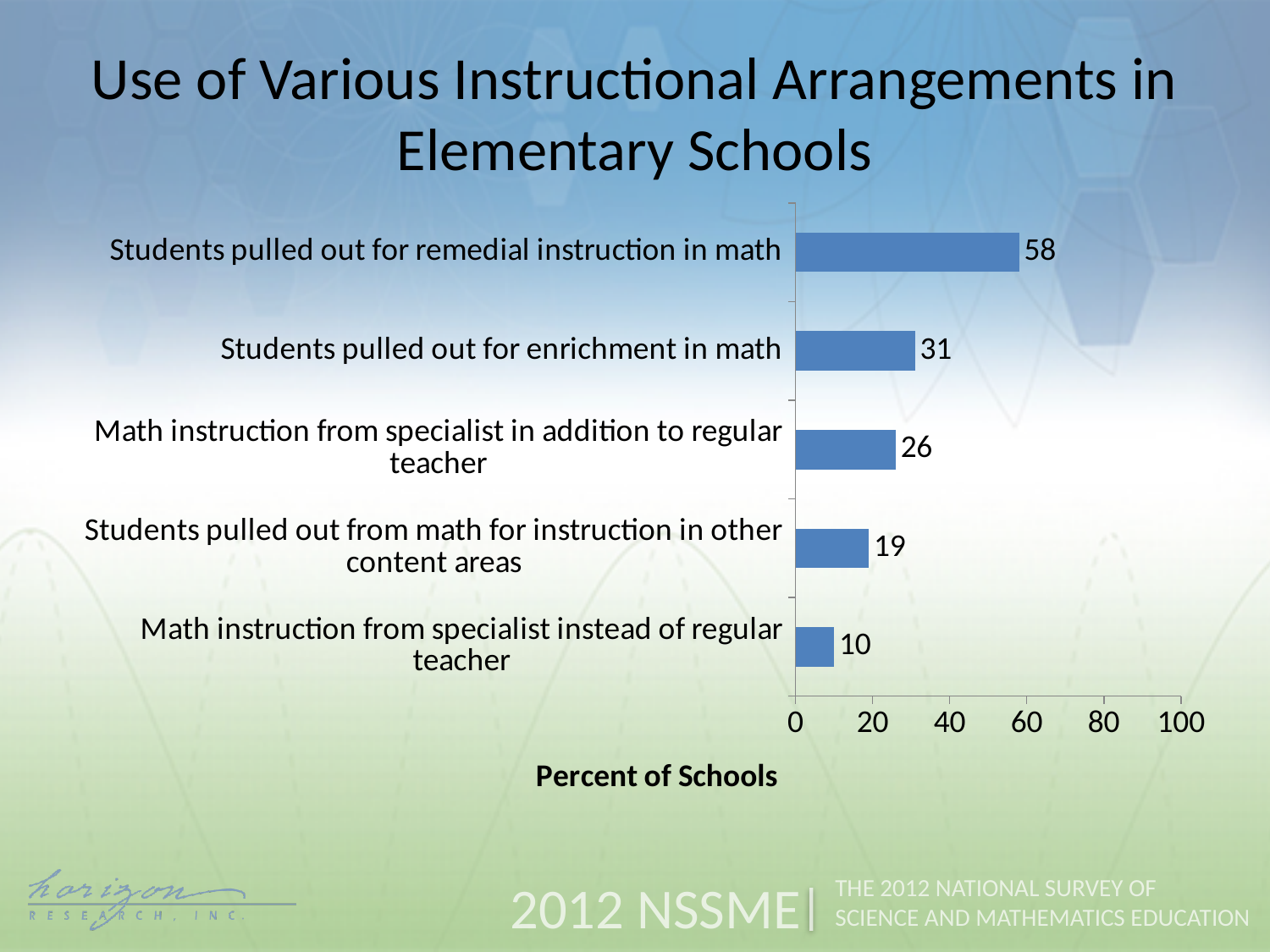
What is the difference between the values for students pulled out for remedial instruction in math and students pulled out for enrichment in math? 27 How many instructional arrangements are shown in the chart? 5 Which is larger: the value for students pulled out from math for instruction in other content areas or the value for math instruction from specialist in addition to regular teacher? Math instruction from specialist in addition to regular teacher Is the value for students pulled out for remedial instruction in math greater or less than 40? greater What is the value for students pulled out for enrichment in math? 31 What is the value for math instruction from specialist instead of regular teacher? 10 Which instructional arrangement has the lowest percent of schools? Math instruction from specialist instead of regular teacher Which instructional arrangement has the highest percent of schools? Students pulled out for remedial instruction in math What kind of chart is shown on the slide? Bar chart What percent of schools report students pulled out for remedial instruction in math? 58 What is the label on the horizontal axis of the chart? Percent of Schools What percent of schools report math instruction from specialist in addition to regular teacher? 26